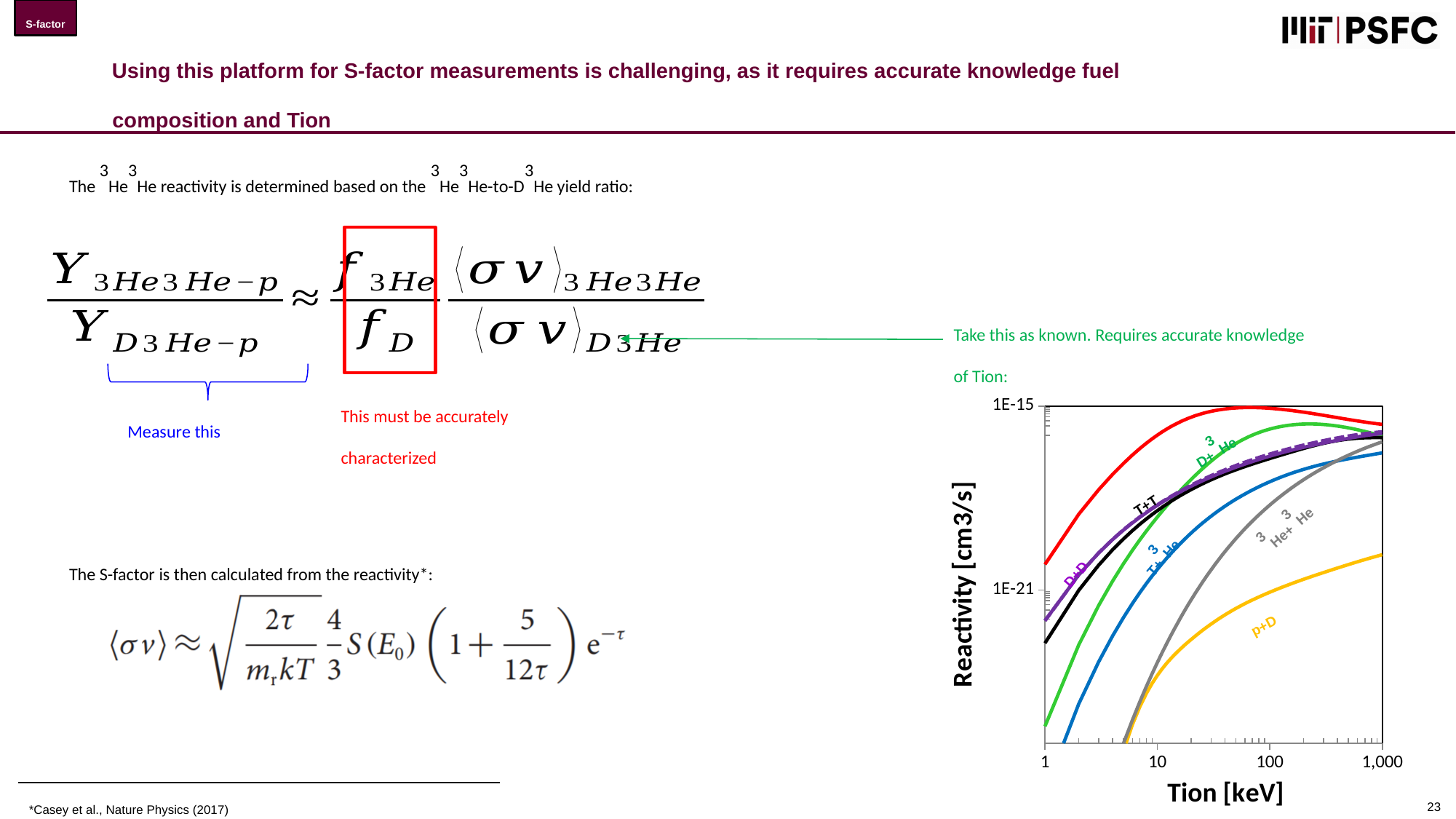
In the reactivity chart, is the D+3He reactivity at 100 keV greater or less than 1E-21? greater In the reactivity chart, is the 3He+3He reactivity at 10 keV greater or less than 1E-21? less In the reactivity chart, at 10 keV, which has the larger reactivity: T+T or 3He+3He? T+T What is the y-axis label of the reactivity chart? Reactivity [cm3/s] In the reactivity chart, at 100 keV, which has the larger reactivity: D+3He or p+D? D+3He What is the x-axis label of the reactivity chart? Tion [keV] In the reactivity chart, does the p+D curve rise or fall as Tion increases? rise What kind of chart is shown on the right of the slide? line chart What is the highest Tion value labeled on the x-axis of the reactivity chart? 1,000 In the reactivity chart, which labeled curve has the lowest reactivity at 100 keV? p+D In the reactivity chart, which curve has the highest reactivity at 10 keV? the red curve In the reactivity chart, is the p+D reactivity at 1,000 keV greater or less than 1E-15? less